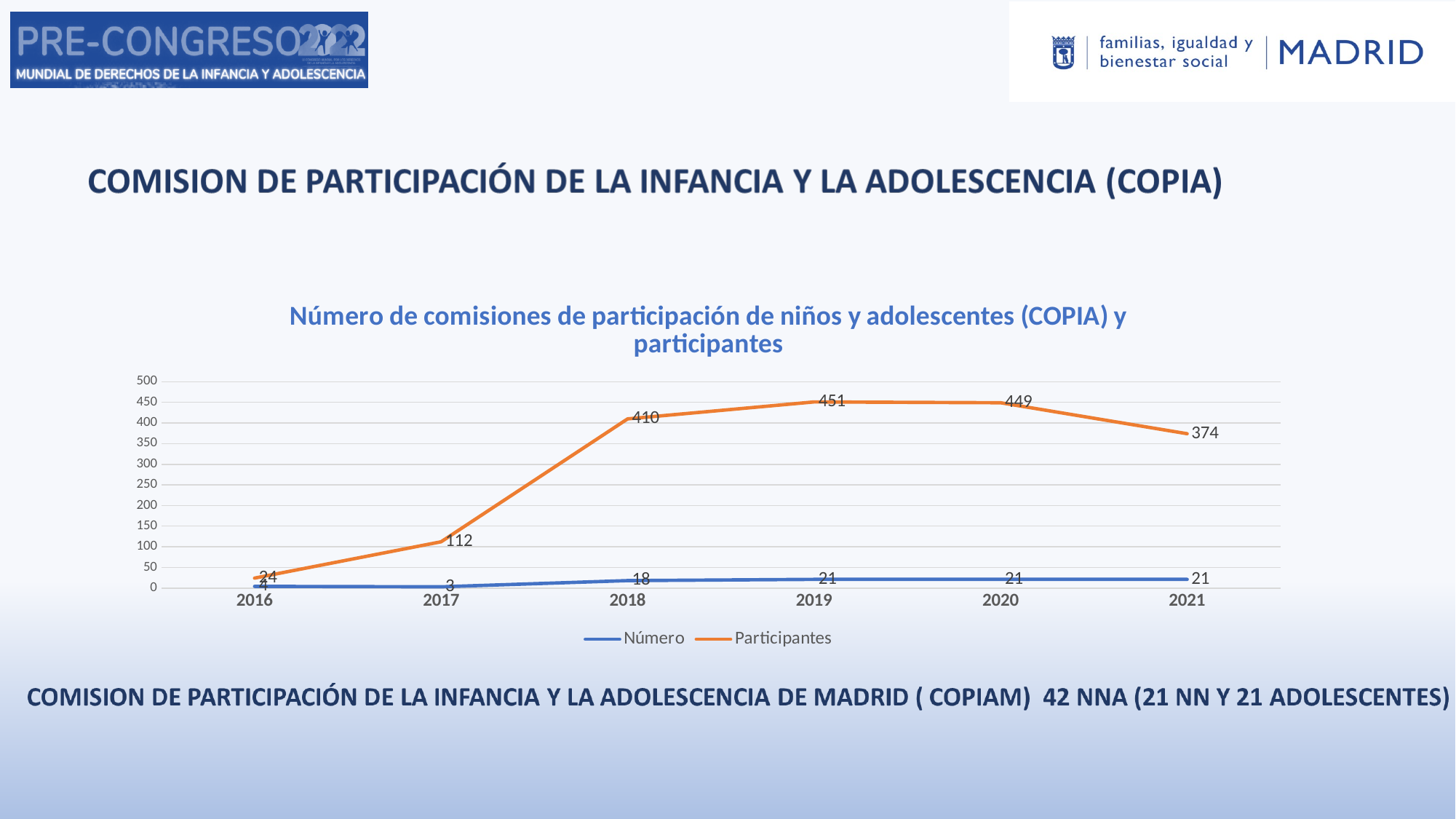
What is the value of Número in 2017? 3 Which series is drawn in orange? Participantes What is the value of Participantes in 2021? 374 What is the value of Número in 2019? 21 How many series does the legend list? 2 In which year is Participantes lowest? 2016 What kind of chart is shown on the slide? Line chart Which is larger, Participantes in 2020 or Participantes in 2021? 2020 What is the value of Participantes in 2018? 410 In which year is Participantes highest? 2019 How many years are plotted along the x axis? 6 What is the difference between Participantes in 2018 and in 2017? 298